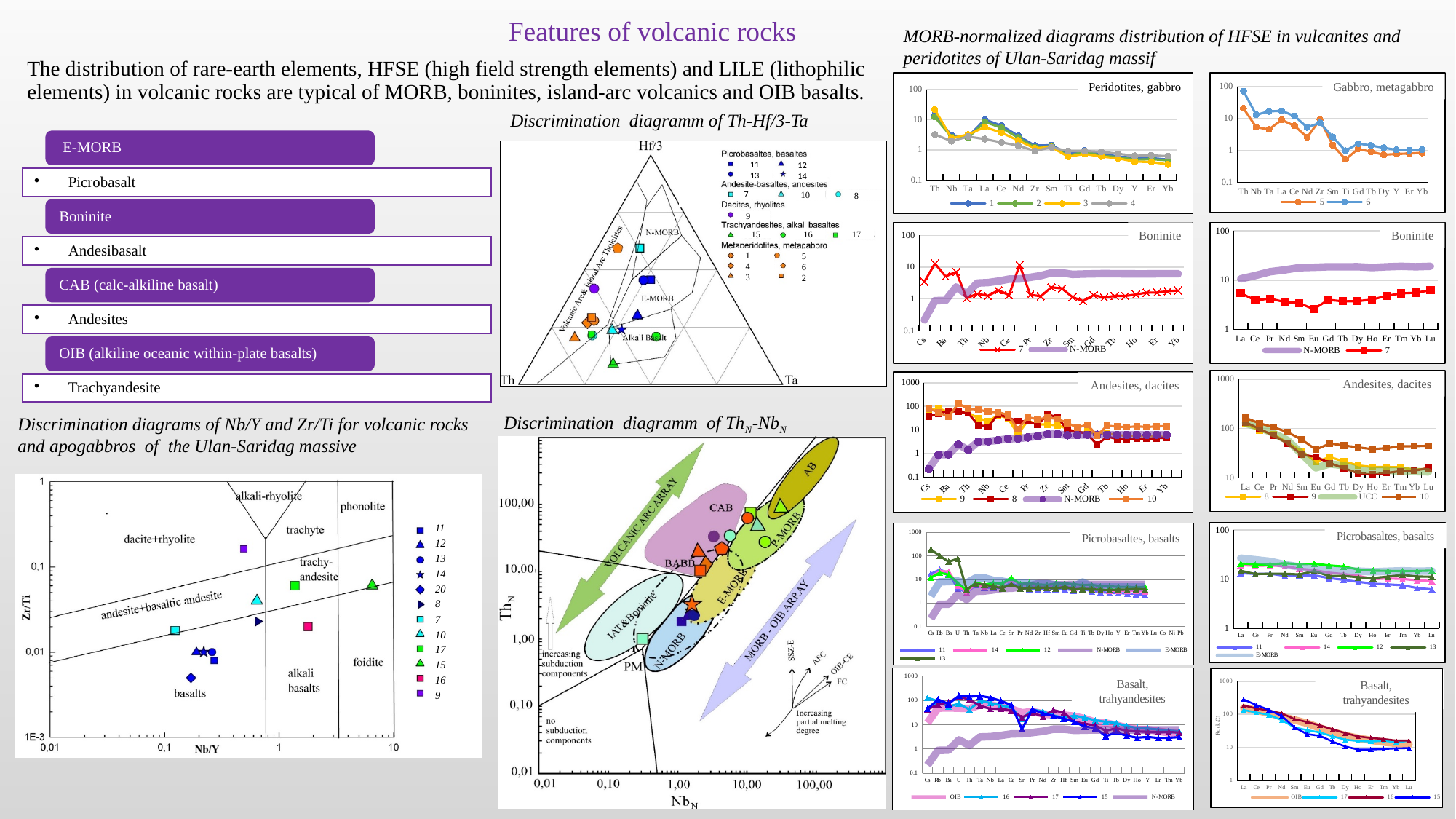
In the right "Boninite" chart (La to Lu), is the value of series 7 at Eu greater or less than 10? less How many elements are shown on the x axis of the "Peridotites, gabbro" chart? 15 In the right "Andesites, dacites" chart (with UCC), which series has the larger value at Lu, 8 or 10? 10 In the "Gabbro, metagabbro" chart, which series has the larger value at Th, 5 or 6? 6 In the right "Andesites, dacites" chart (with UCC), how many series does the legend list? 4 In the right "Boninite" chart (La to Lu), does the N-MORB series rise or fall from La to Lu? rise In the left "Picrobasaltes, basalts" chart (with N-MORB and E-MORB), how many series does the legend list? 6 In the "Gabbro, metagabbro" chart, how many series does the legend list? 2 In the right "Basalt, trahyandesites" chart (La to Lu), does series 15 rise or fall from La to Lu? fall In the "Peridotites, gabbro" chart, is the value of series 4 at Th greater or less than 10? less In the "Gabbro, metagabbro" chart, is the value of series 6 at Th greater or less than 10? greater